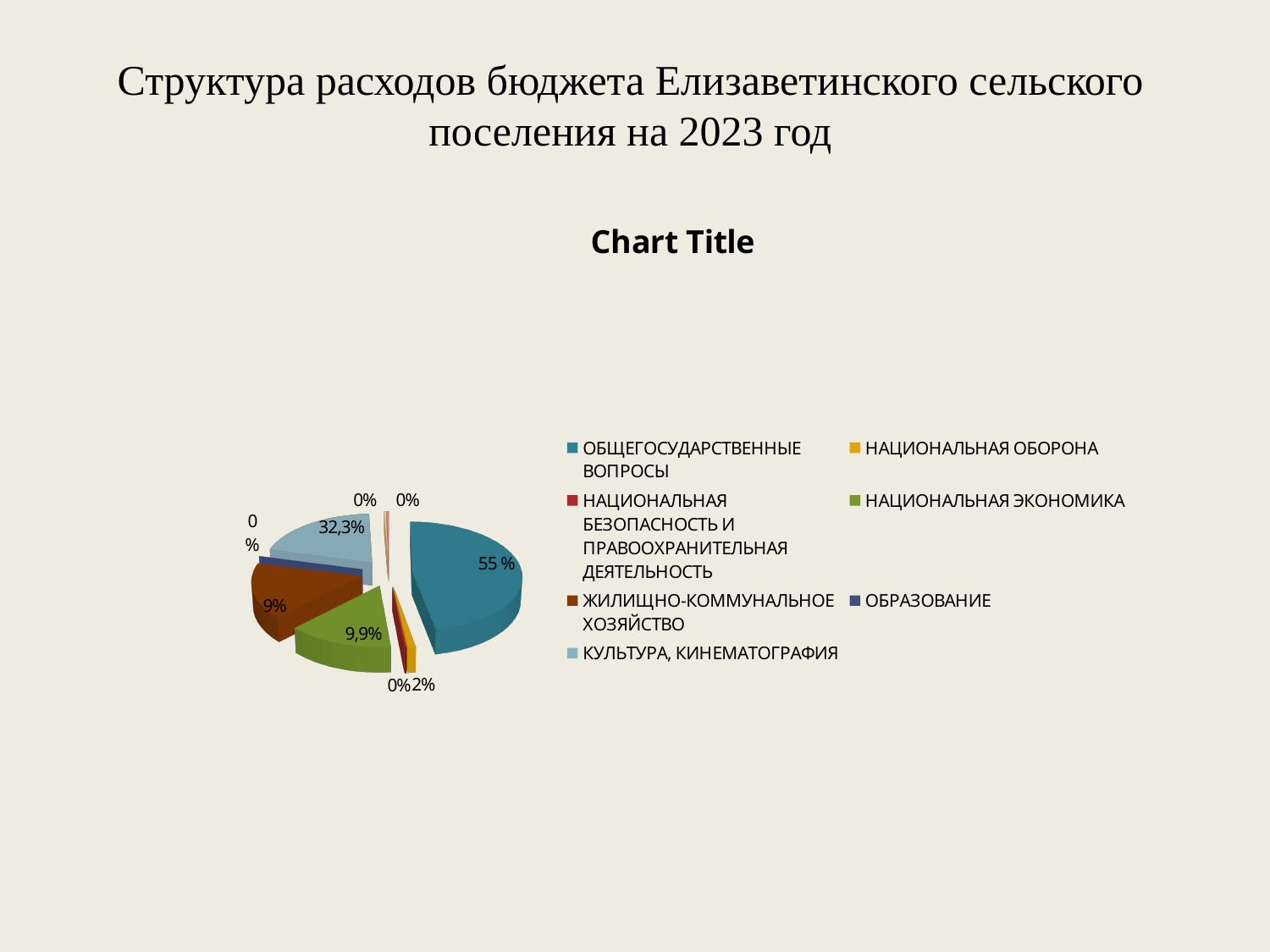
What share of the pie is labelled for ОБЩЕГОСУДАРСТВЕННЫЕ ВОПРОСЫ? 55 % What share of the pie is labelled for КУЛЬТУРА, КИНЕМАТОГРАФИЯ? 32,3% Which is larger: the slice for ОБЩЕГОСУДАРСТВЕННЫЕ ВОПРОСЫ or the slice for КУЛЬТУРА, КИНЕМАТОГРАФИЯ? ОБЩЕГОСУДАРСТВЕННЫЕ ВОПРОСЫ Which category has the largest slice of the pie? ОБЩЕГОСУДАРСТВЕННЫЕ ВОПРОСЫ What share of the pie is labelled for НАЦИОНАЛЬНАЯ ОБОРОНА? 2% What share of the pie is labelled for ЖИЛИЩНО-КОММУНАЛЬНОЕ ХОЗЯЙСТВО? 9% What kind of chart is shown on the slide? pie chart What colour is the slice for ОБЩЕГОСУДАРСТВЕННЫЕ ВОПРОСЫ in the pie chart? teal blue What share of the pie is labelled for НАЦИОНАЛЬНАЯ ЭКОНОМИКА? 9,9% What is the title shown above the pie chart? Chart Title How many entries does the legend of the pie chart list? 7